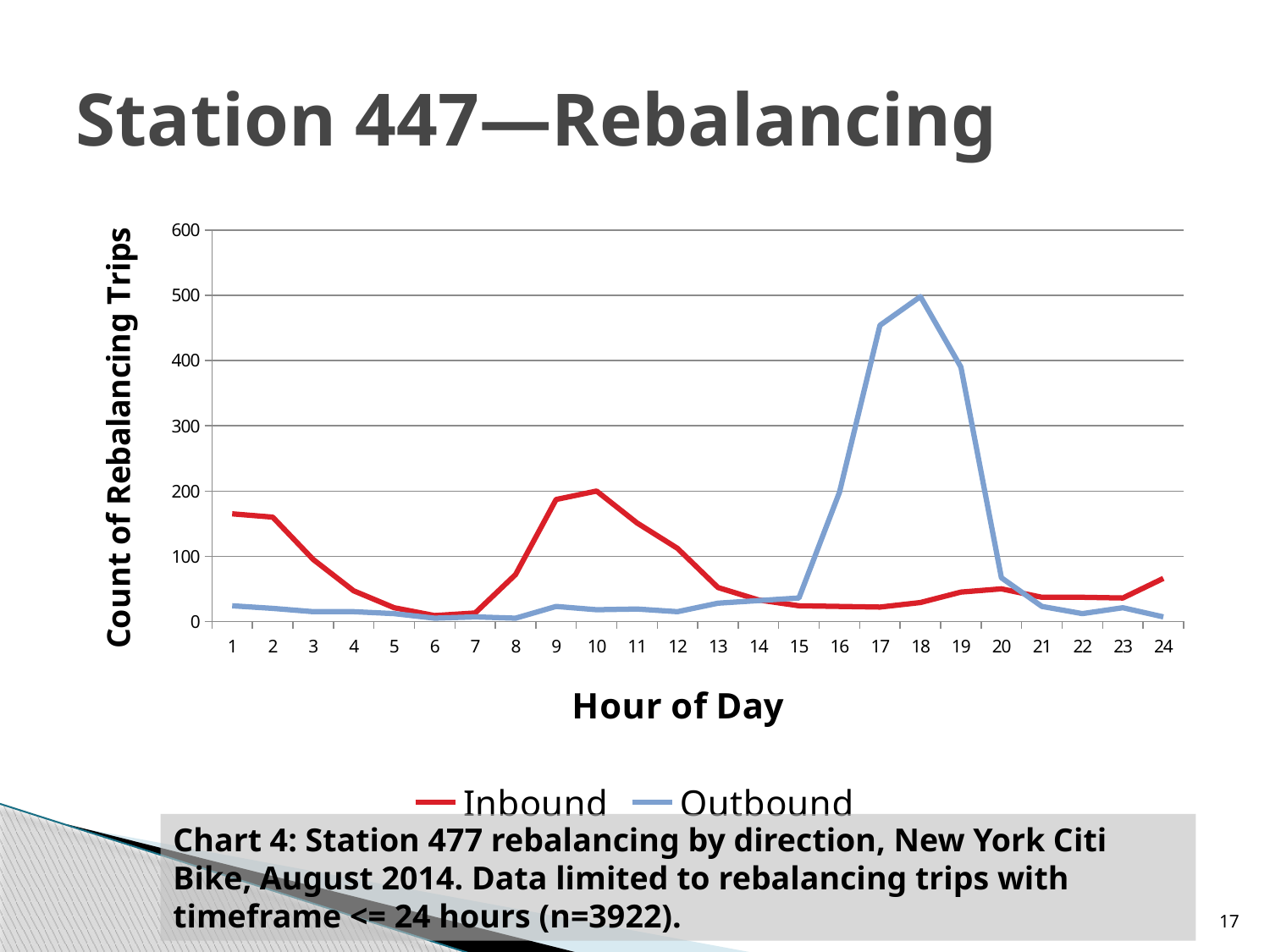
How many hours of the day are plotted along the x axis? 24 At which hour of the day does the Inbound series reach its highest value? 10 Is the Inbound value at hour 1 greater or less than 100? greater At hour 10, which series has the larger value, Inbound or Outbound? Inbound How many series does the legend list? 2 At hour 18, which series has the larger value, Inbound or Outbound? Outbound Is the Inbound value at hour 6 greater or less than 100? less At which hour of the day does the Outbound series reach its highest value? 18 Is the Outbound value at hour 18 greater or less than 400? greater What kind of chart is shown on the slide? Line chart Does the Outbound series rise or fall between hour 15 and hour 18? Rise What is the title of the y axis? Count of Rebalancing Trips